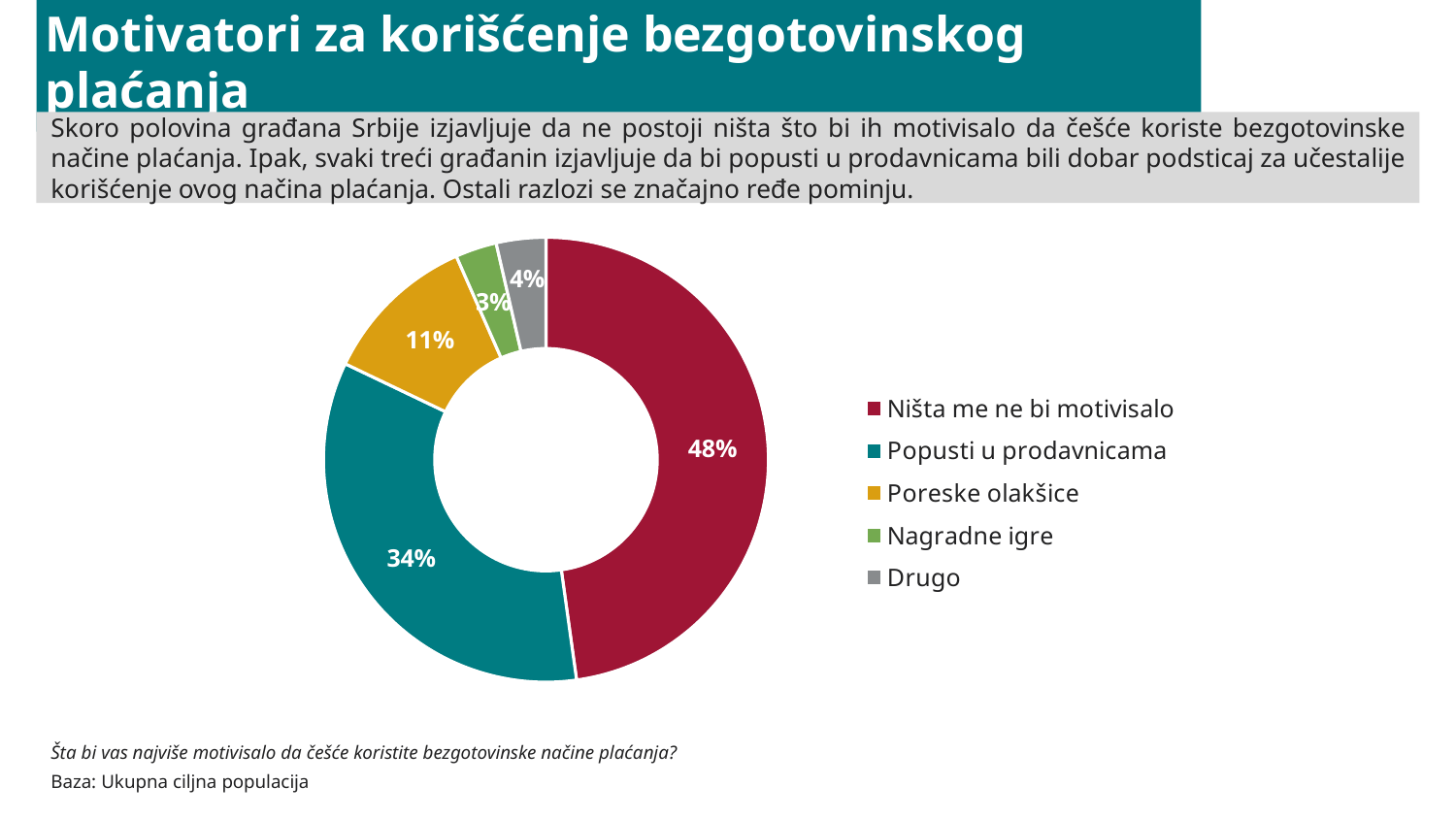
What is the value for "Nagradne igre"? 3% Which category has the largest share of the chart? Ništa me ne bi motivisalo Which category has the smallest share of the chart? Nagradne igre What percentage of respondents chose "Ništa me ne bi motivisalo"? 48% What colour is the slice for "Poreske olakšice"? Yellow/gold What is the value for "Poreske olakšice"? 11% What is the value for "Drugo"? 4% What kind of chart is shown on the slide? Pie chart (doughnut) How many categories does the chart show? 5 Which is larger, the share for "Drugo" or the share for "Nagradne igre"? Drugo What share of the chart is "Popusti u prodavnicama"? 34% What is the difference between the shares for "Ništa me ne bi motivisalo" and "Popusti u prodavnicama"? 14%